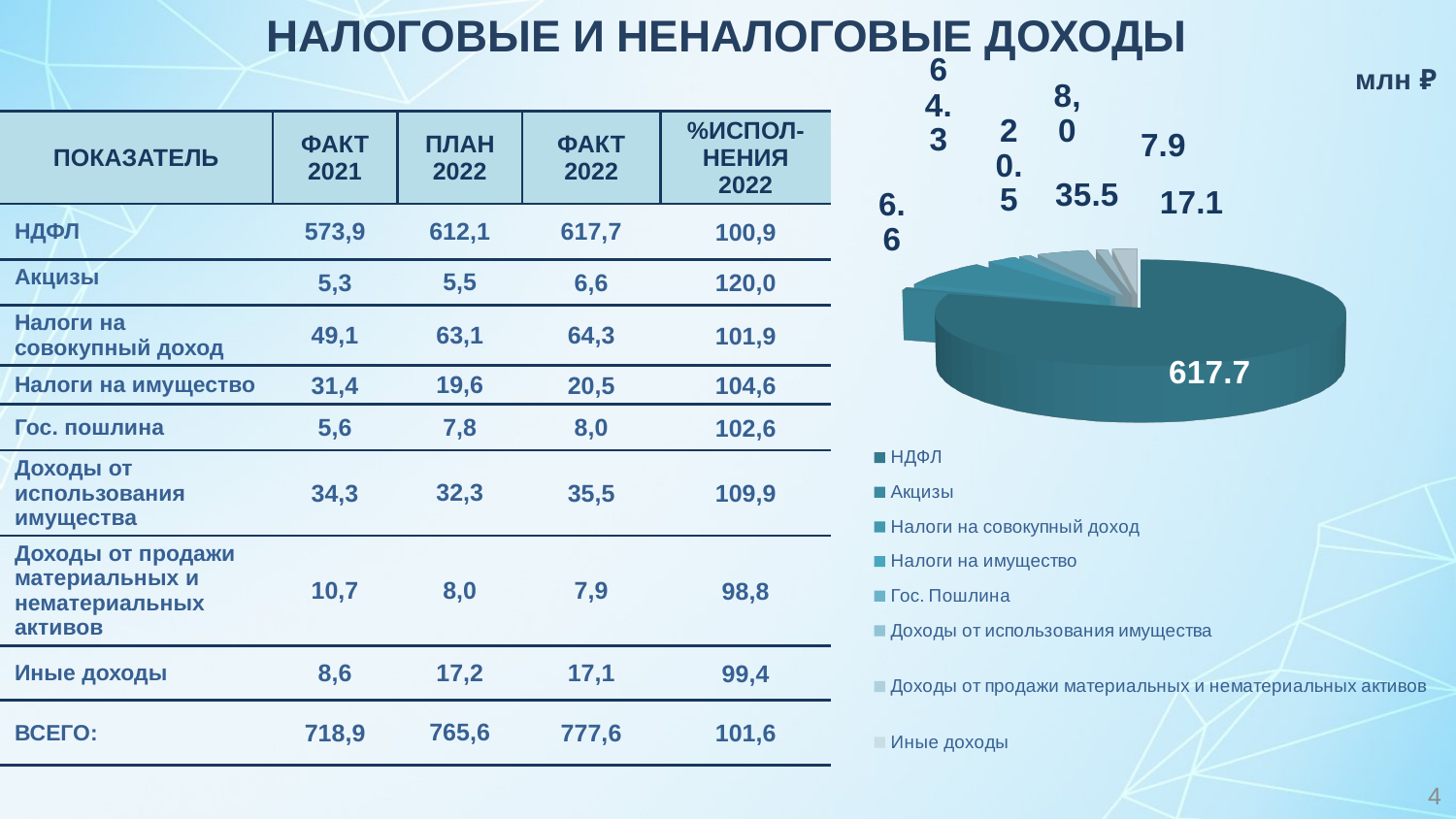
What value is shown for Иные доходы on the pie chart? 17.1 In the pie chart, which is larger: НДФЛ or Иные доходы? НДФЛ What value is shown for НДФЛ on the pie chart? 617.7 What value is shown for Доходы от продажи материальных и нематериальных активов on the pie chart? 7.9 What value is shown for Доходы от использования имущества on the pie chart? 35.5 What is the first entry in the pie chart's legend? НДФЛ What unit is indicated in the top right corner of the pie chart? млн ₽ How many entries does the legend of the pie chart list? 8 In the pie chart, what is the difference between Доходы от использования имущества (35.5) and Иные доходы (17.1)? 18.4 In the pie chart, which is larger: Иные доходы or Доходы от использования имущества? Доходы от использования имущества What kind of chart is shown on the right side of the slide? pie chart Which category has the largest slice in the pie chart? НДФЛ